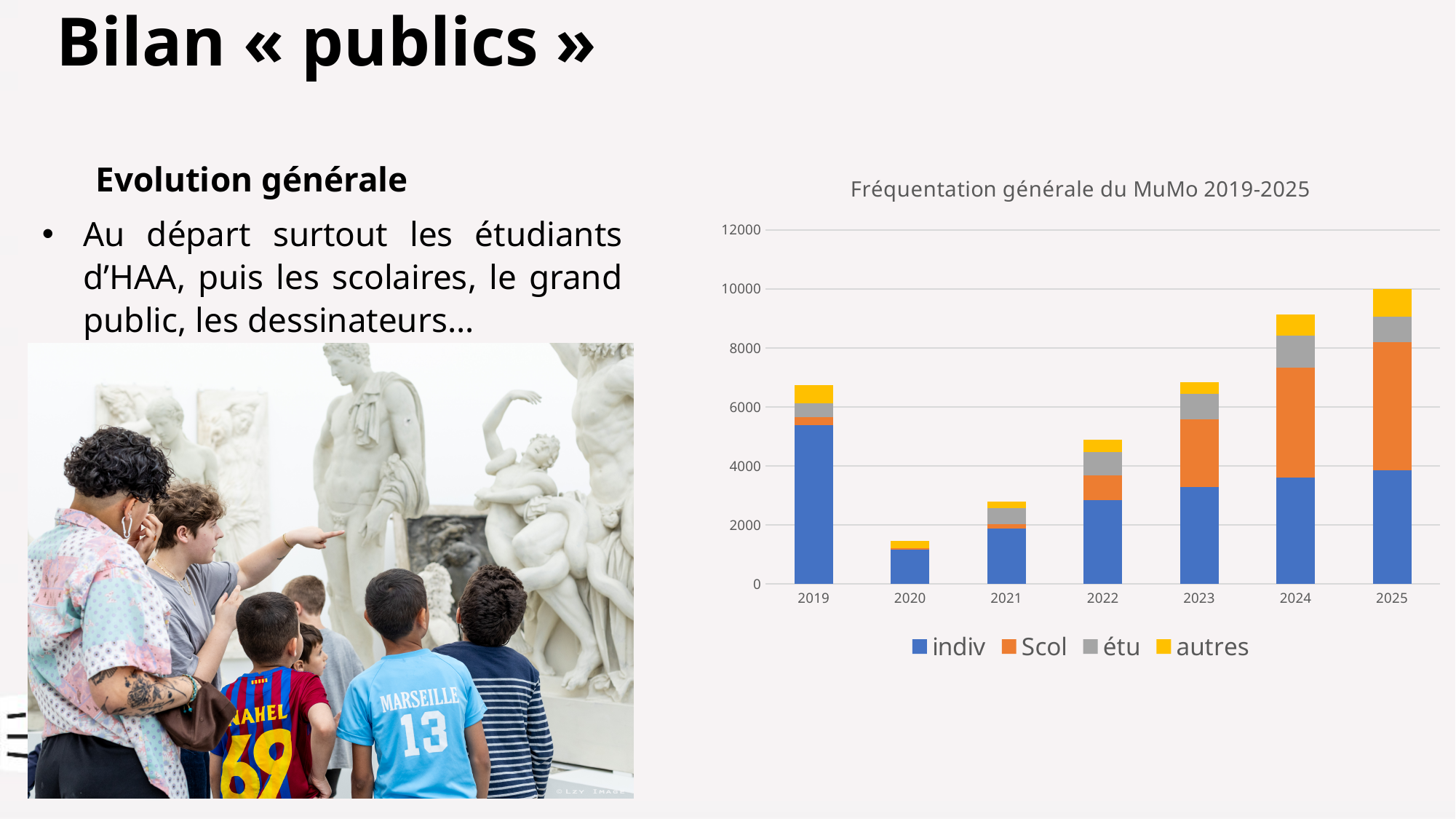
What kind of chart is shown on the slide? Stacked bar chart Which year has the larger total attendance, 2023 or 2024? 2024 Is the value for indiv in 2019 greater or less than 4000? greater What is the title of the chart? Fréquentation générale du MuMo 2019-2025 Is the total attendance for 2020 greater or less than 2000? less Which year has the lowest total attendance in the chart? 2020 Is the total attendance for 2021 greater or less than 4000? less Does the total attendance rise or fall from 2020 to 2025? rise Which year has the highest total attendance in the chart? 2025 How many years are shown on the x axis of the chart? 7 How many series does the chart legend list? 4